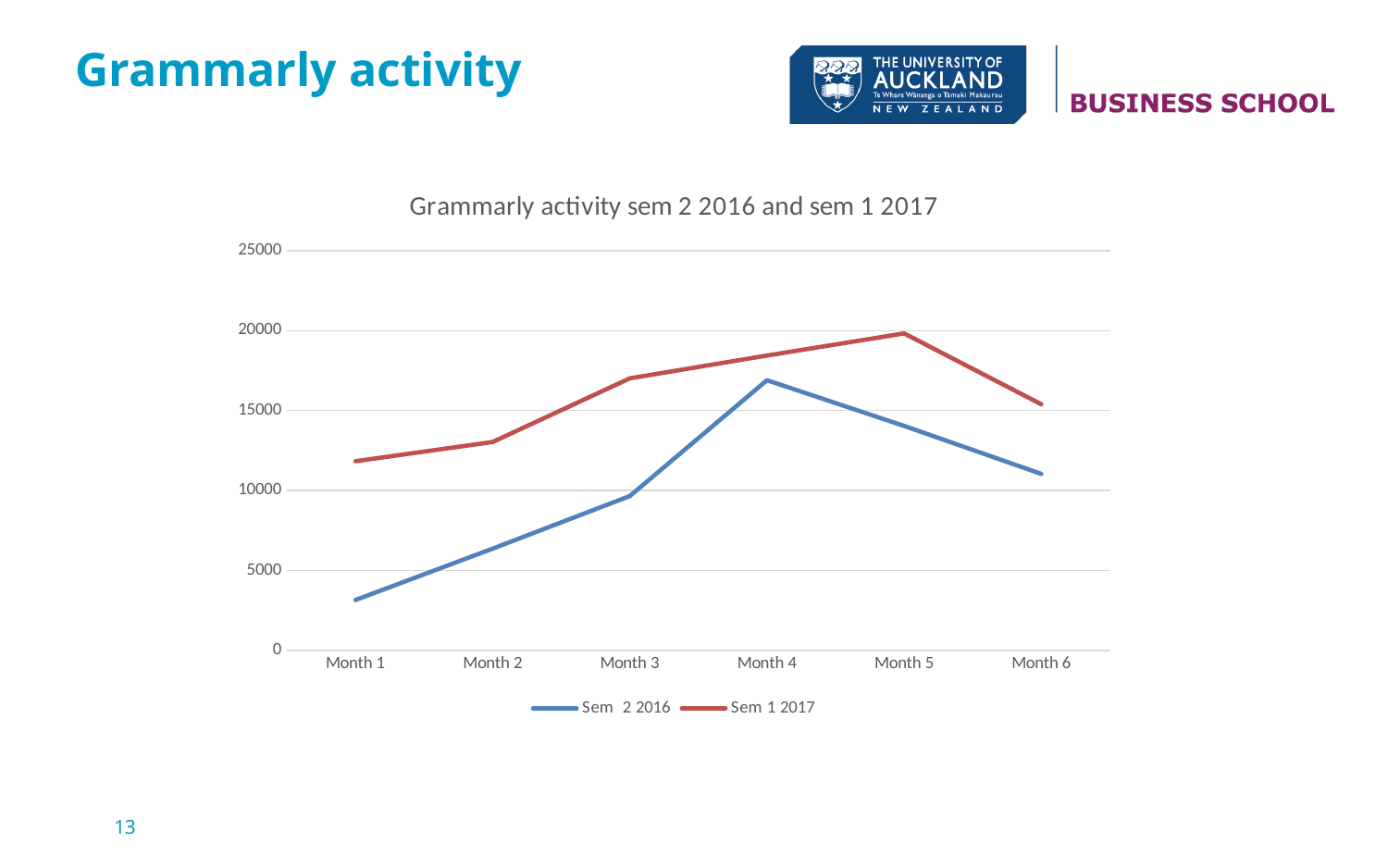
What is the title of the chart? Grammarly activity sem 2 2016 and sem 1 2017 Is the value for Sem 1 2017 in Month 5 greater or less than 15000? greater Does the Sem 1 2017 series rise or fall from Month 1 to Month 5? Rise In which month is the Sem 1 2017 series at its lowest? Month 1 In which month does the Sem 1 2017 series reach its highest value? Month 5 In which month does the Sem 2 2016 series reach its highest value? Month 4 Is the value for Sem 2 2016 in Month 1 greater or less than 5000? less How many series does the legend list? 2 What type of chart is shown on the slide? Line chart In Month 3, which series has the higher value, Sem 2 2016 or Sem 1 2017? Sem 1 2017 In which month is the Sem 2 2016 series at its lowest? Month 1 How many months are plotted along the x axis? 6